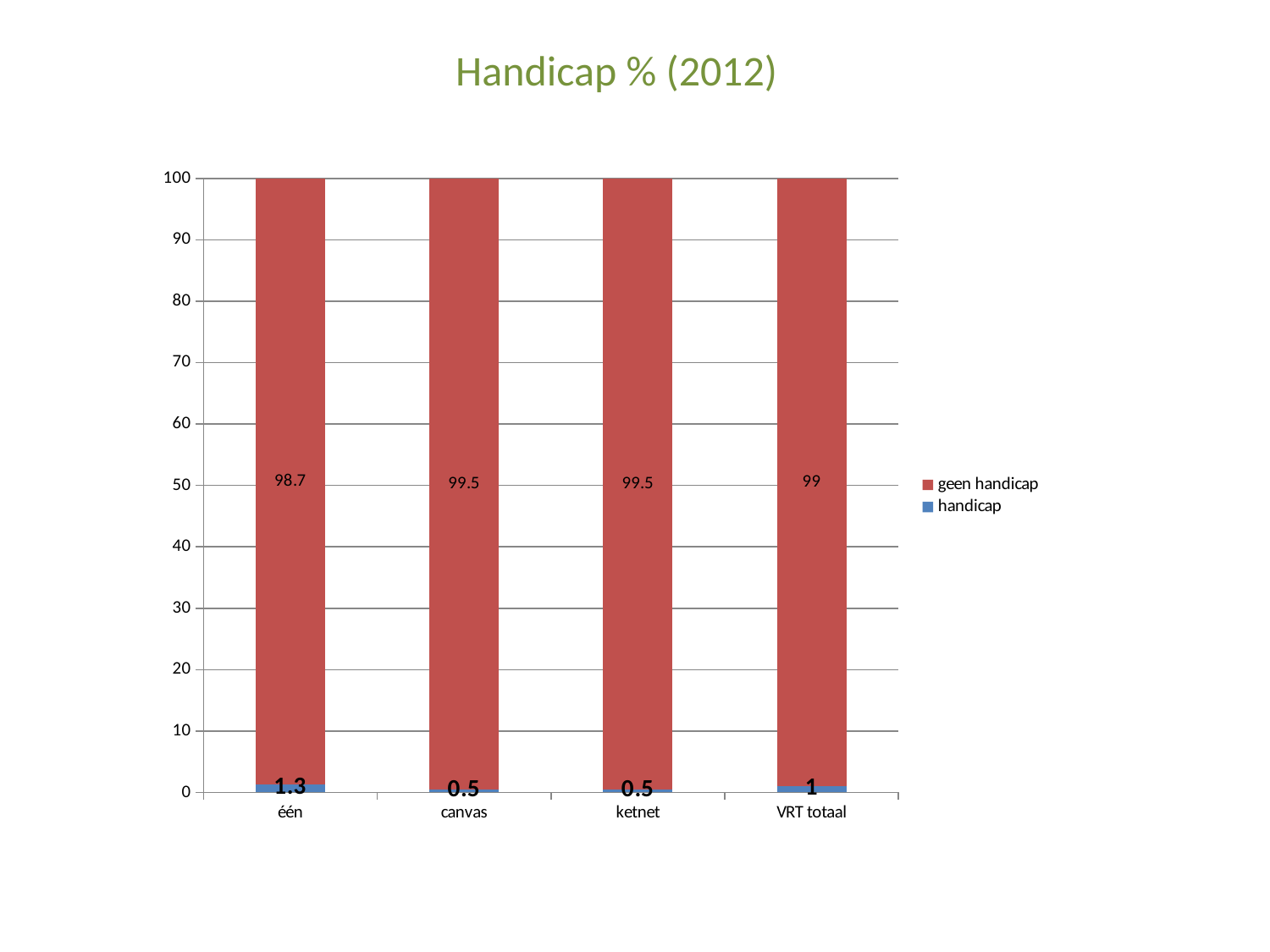
Which category has the lowest 'geen handicap' value? één What kind of chart is shown? stacked bar chart What is the title of the chart? Handicap % (2012) How many categories are shown on the x axis? 4 Which is larger, the 'handicap' value for één or for ketnet? één What is the 'handicap' value for canvas? 0.5 What is the 'handicap' value for VRT totaal? 1 What is the difference between the 'handicap' values for één and VRT totaal? 0.3 What is the 'geen handicap' value for één? 98.7 How many series does the legend list? 2 What is the 'geen handicap' value for ketnet? 99.5 Which category has the highest 'handicap' value? één